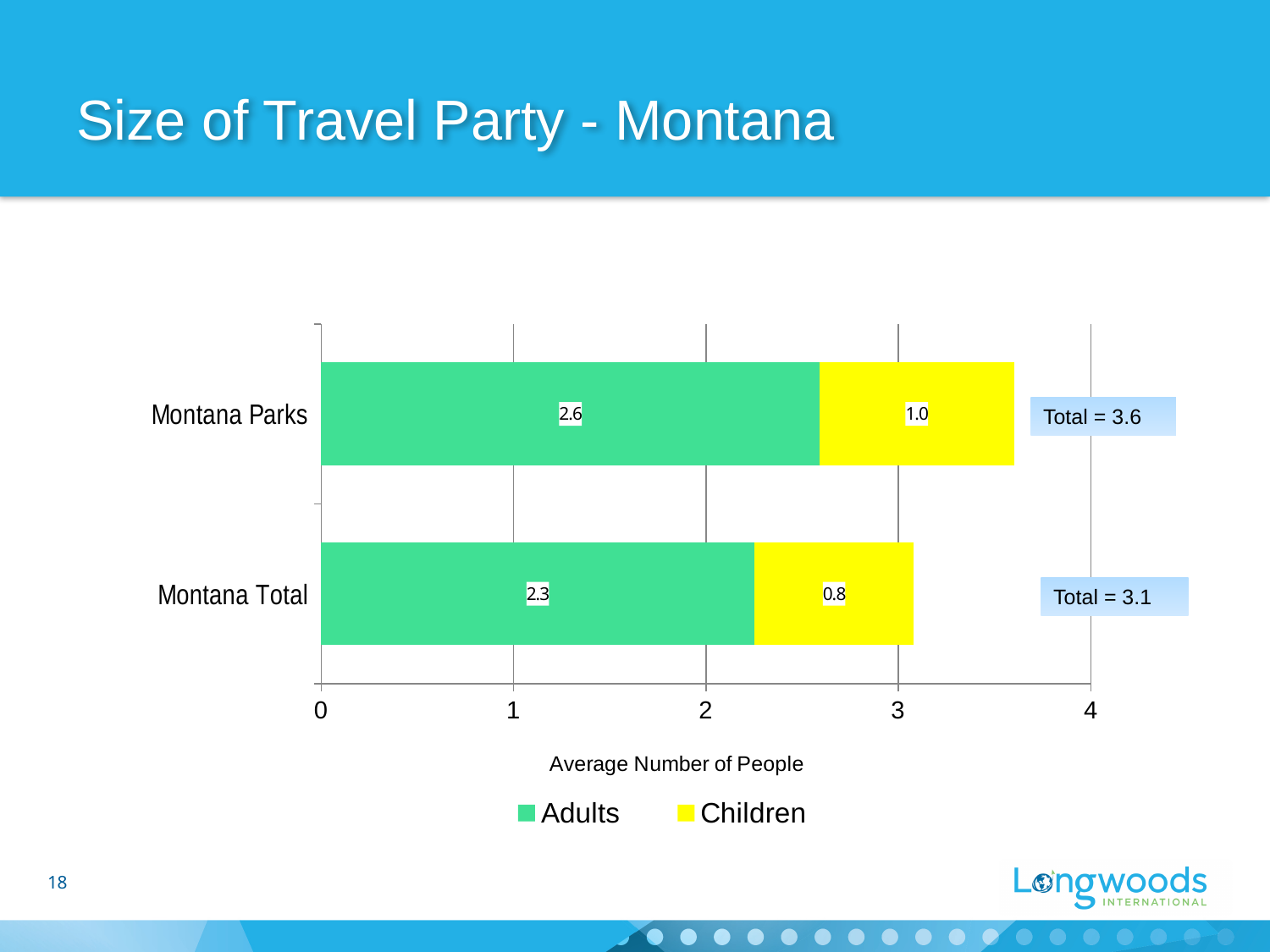
Which category has the higher average number of adults, Montana Parks or Montana Total? Montana Parks What is the average number of adults in the travel party for Montana Parks? 2.6 What is the difference in the average number of adults between Montana Parks and Montana Total? 0.3 Which category has the lowest average number of children? Montana Total What is the total travel party size for Montana Parks? 3.6 What type of chart is shown on the slide? Stacked bar chart How many series does the legend list? 2 What is the difference in total travel party size between Montana Parks and Montana Total? 0.5 What is the label of the x axis? Average Number of People What is the average number of children in the travel party for Montana Total? 0.8 What is the average number of children in the travel party for Montana Parks? 1.0 What is the total travel party size for Montana Total? 3.1